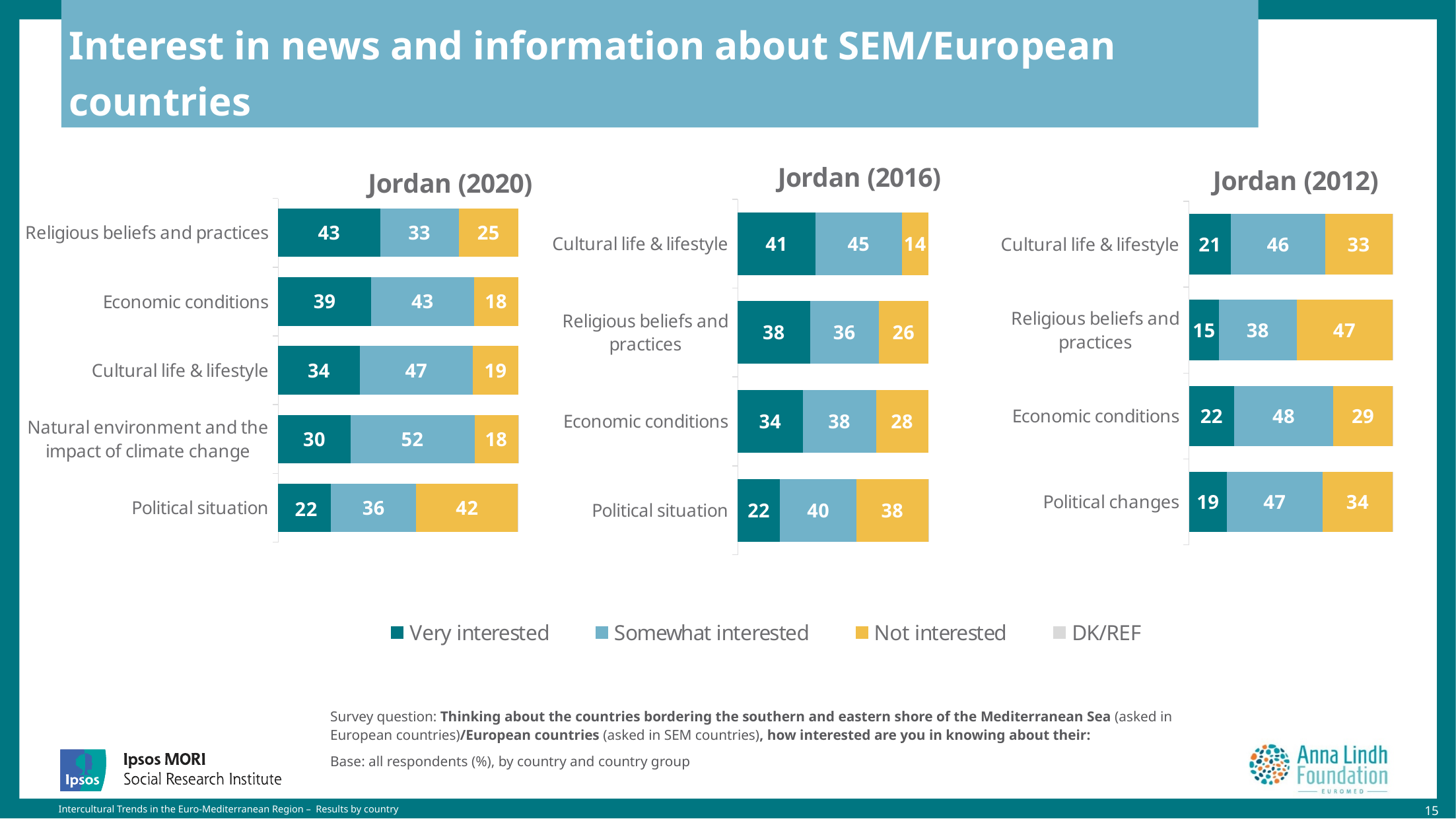
How many series does the legend list? 4 In the Jordan (2016) chart, what is the 'Not interested' value for 'Political situation'? 38 In the Jordan (2016) chart, what is the total of the 'Political situation' bar? 100 In the Jordan (2012) chart, what is the 'Somewhat interested' value for 'Economic conditions'? 48 In the Jordan (2020) chart, how much higher is the 'Not interested' value for 'Political situation' than for 'Economic conditions'? 24 In the Jordan (2020) chart, what percentage is 'Very interested' for 'Natural environment and the impact of climate change'? 30 How many categories are shown in the Jordan (2020) chart? 5 In the Jordan (2020) chart, which category has the highest 'Very interested' value? Religious beliefs and practices In the Jordan (2016) chart, which has the larger 'Very interested' value: 'Cultural life & lifestyle' or 'Religious beliefs and practices'? Cultural life & lifestyle In the Jordan (2012) chart, which category has the highest 'Not interested' value? Religious beliefs and practices What type of chart is used for Jordan (2016)? Stacked bar chart In the Jordan (2012) chart, which category has the lowest 'Very interested' value? Religious beliefs and practices